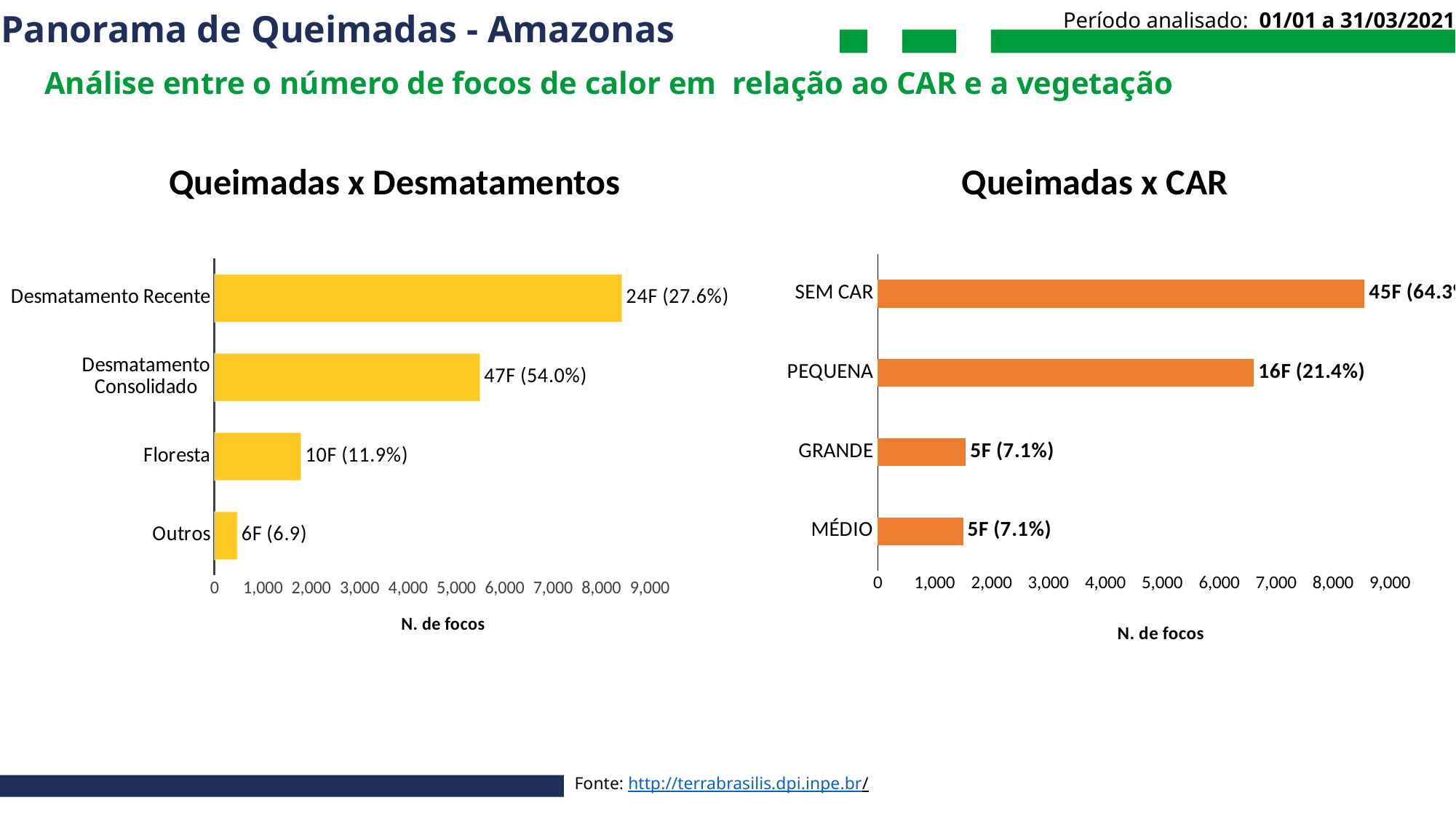
In the 'Queimadas x Desmatamentos' chart, what is the data label shown for Floresta? 10F (11.9%) In the 'Queimadas x CAR' chart, what is the data label shown for GRANDE? 5F (7.1%) In the 'Queimadas x CAR' chart, what is the data label shown for PEQUENA? 16F (21.4%) In the 'Queimadas x Desmatamentos' chart, which category has the shortest bar? Outros In the 'Queimadas x Desmatamentos' chart, is the bar for Desmatamento Recente greater or less than 8,000 on the N. de focos axis? greater In the 'Queimadas x CAR' chart, is the bar for PEQUENA greater or less than 6,000 on the N. de focos axis? greater What type of chart is 'Queimadas x Desmatamentos'? Bar chart In the 'Queimadas x Desmatamentos' chart, which category has the longest bar? Desmatamento Recente In the 'Queimadas x Desmatamentos' chart, what is the data label shown for Desmatamento Consolidado? 47F (54.0%) How many categories are shown in the 'Queimadas x CAR' chart? 4 In the 'Queimadas x CAR' chart, which category has the longest bar? SEM CAR In the 'Queimadas x Desmatamentos' chart, which bar is longer: Desmatamento Consolidado or Floresta? Desmatamento Consolidado